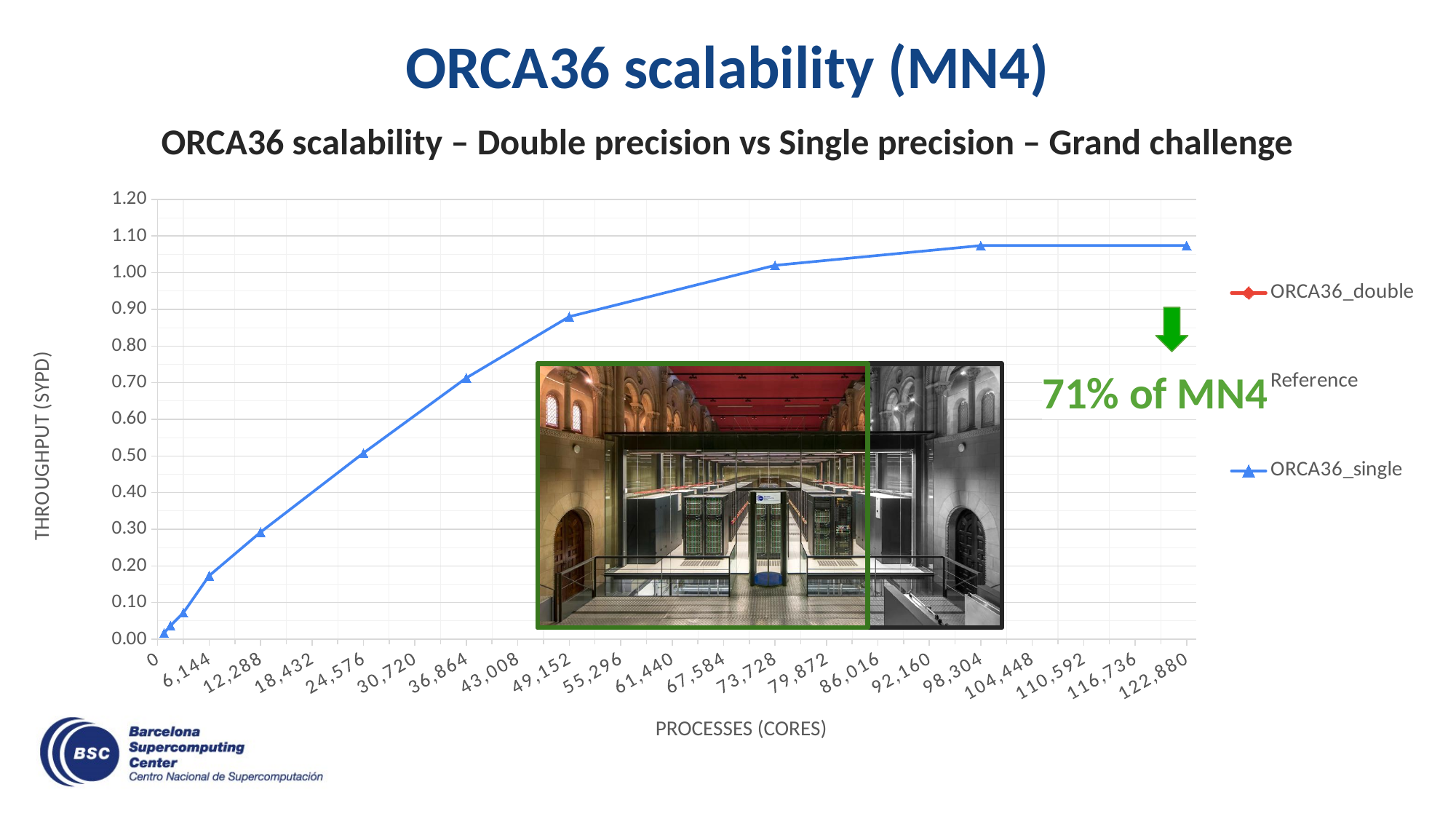
Is the ORCA36_single value at 49,152 processes greater or less than 0.80? greater What kind of chart is shown on the slide? line chart Is the ORCA36_single value at 73,728 processes greater or less than 0.90? greater Is the ORCA36_single value at 12,288 processes greater or less than 0.40? less What is the title of the chart? ORCA36 scalability – Double precision vs Single precision – Grand challenge How many series does the chart legend list? 3 At which number of processes is the ORCA36_single throughput lowest? 0 Which is larger for ORCA36_single: the value at 49,152 processes or the value at 24,576 processes? 49,152 processes What is the label of the y axis? THROUGHPUT (SYPD) Does the ORCA36_single throughput rise or fall as the number of processes increases? rise